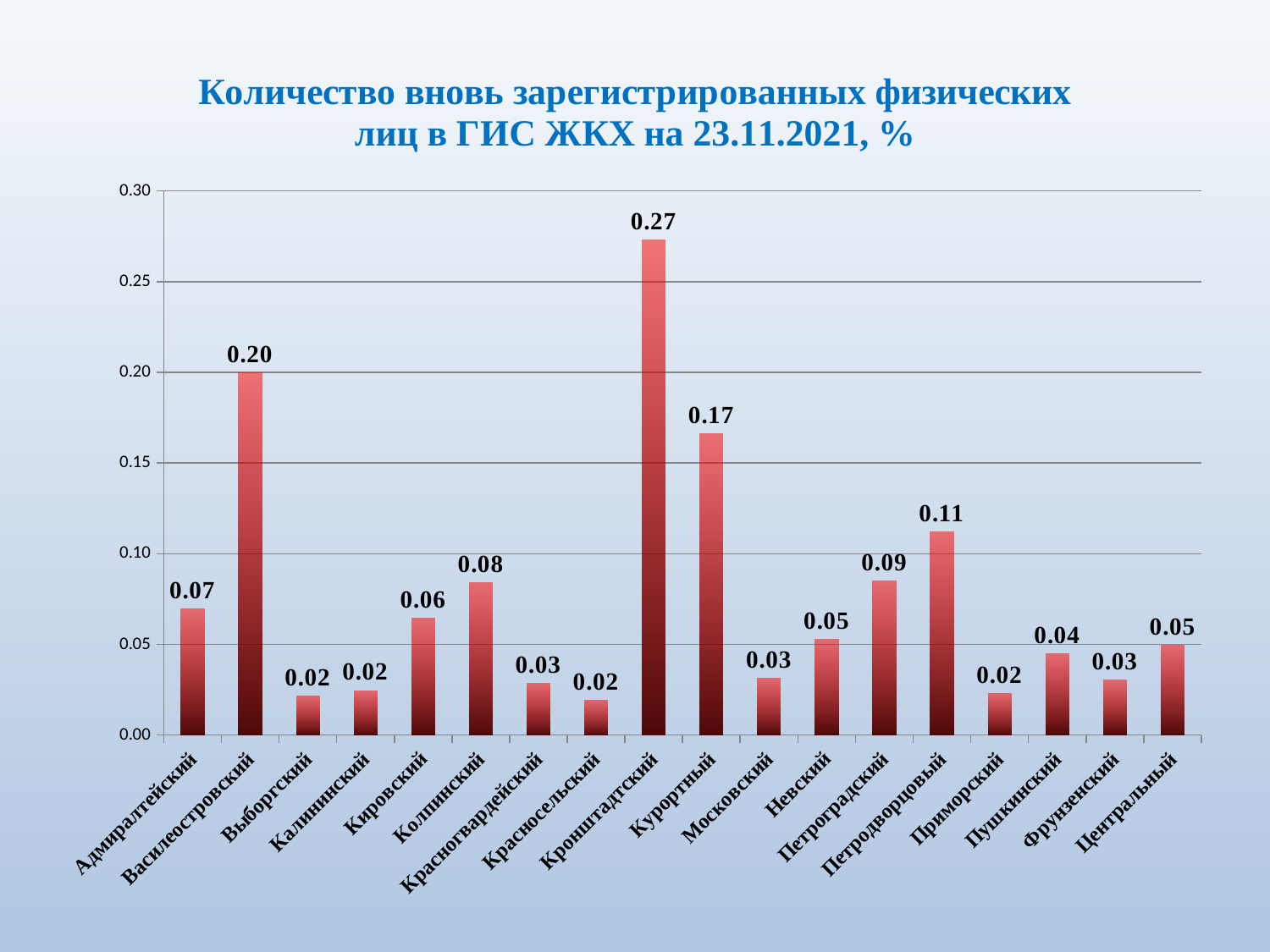
What is the difference between the values for Курортный and Петроградский? 0.08 What is the difference between the values for Кронштадтский and Василеостровский? 0.07 Which is larger, the value for Курортный or the value for Петродворцовый? Курортный Which district has the highest value? Кронштадтский What date is given in the chart title? 23.11.2021 What is the value for Петродворцовый? 0.11 What is the value for Василеостровский? 0.20 What is the value for Пушкинский? 0.04 Is the value for Кронштадтский greater or less than 0.25? greater What is the value for Кронштадтский? 0.27 What kind of chart is shown on the slide? bar chart How many districts are shown on the x axis? 18